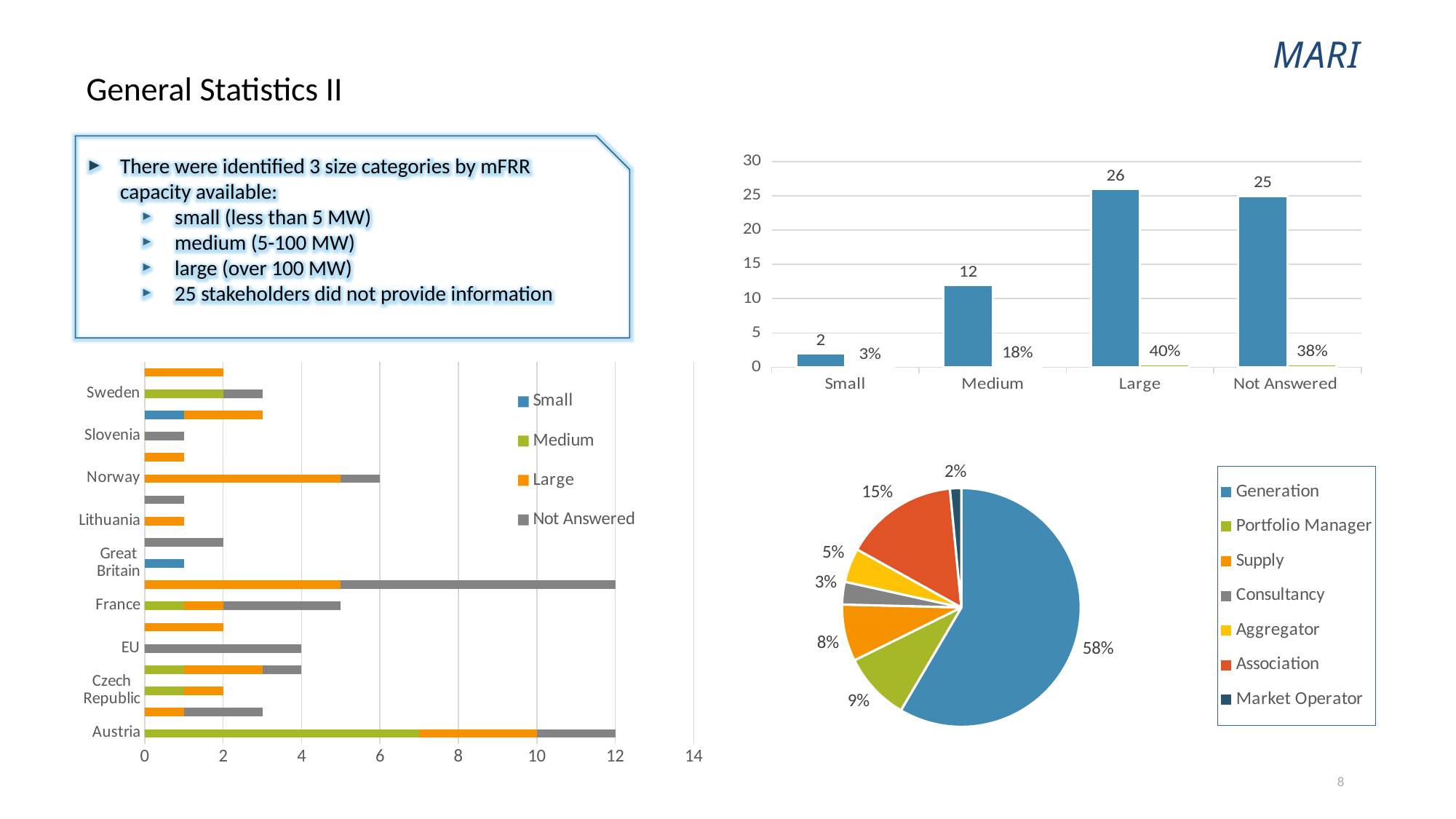
In the top-right bar chart, what is the value for Large? 26 In the top-right bar chart, what is the difference between the values for Medium and Small? 10 In the top-right bar chart, which category has the lowest value? Small In the bottom-right pie chart, what share does Association have? 15% In the top-right bar chart, which category has the highest value? Large In the bottom-right pie chart, what share does Generation have? 58% In the bottom-right pie chart, which is larger, Supply or Aggregator? Supply In the top-right bar chart, how many categories are shown on the x axis? 4 In the bottom-right pie chart, which category has the smallest slice? Market Operator In the top-right bar chart, what is the value for Small? 2 How many series does the legend of the bottom-left chart list? 4 In the top-right bar chart, what percentage is shown for Medium? 18%